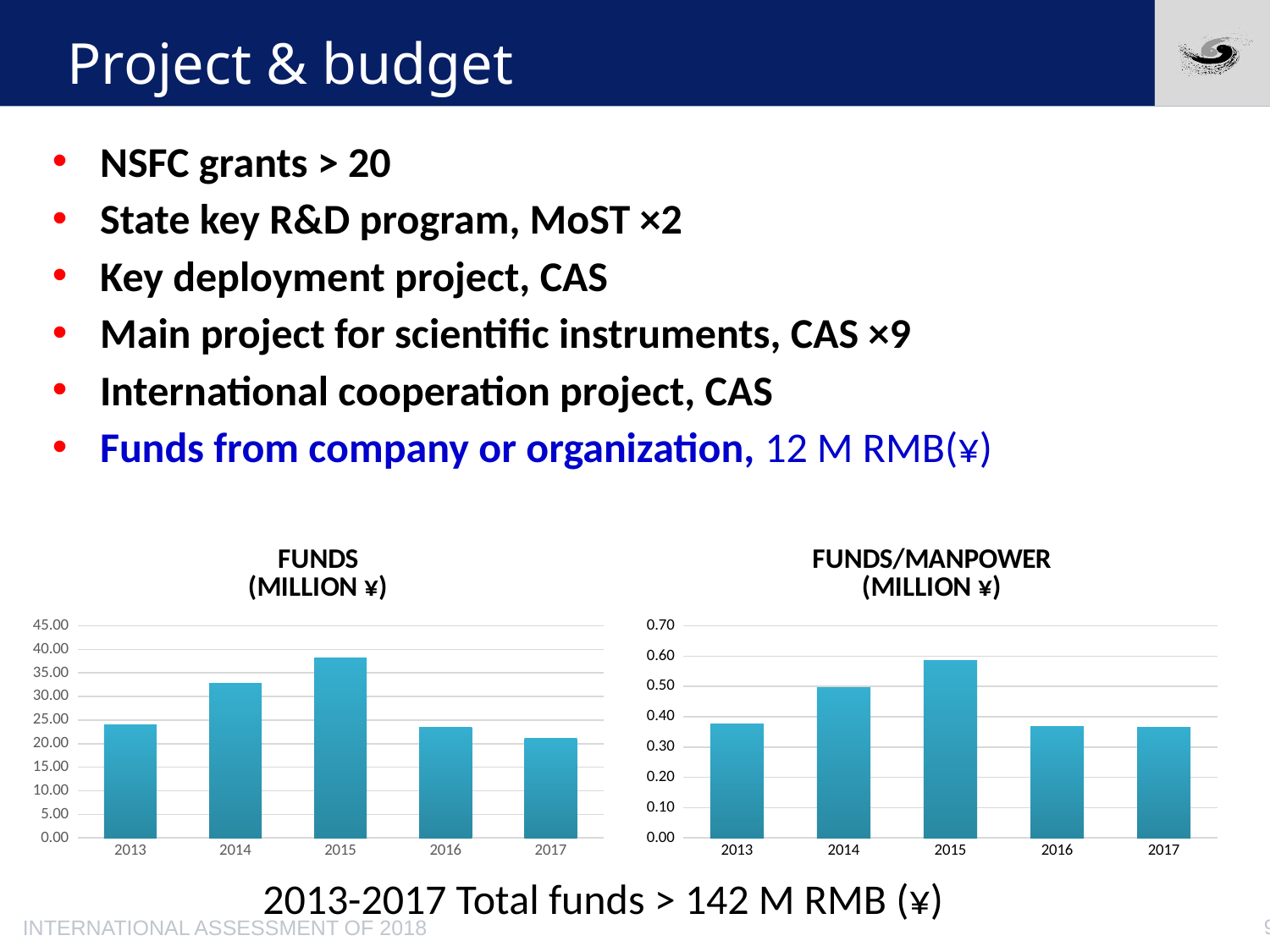
In the FUNDS/MANPOWER (MILLION ¥) chart, is the value for 2013 greater or less than 0.40? less In the FUNDS (MILLION ¥) chart, is the value for 2014 greater or less than 30.00? greater What kind of chart is the FUNDS (MILLION ¥) chart? bar chart In the FUNDS (MILLION ¥) chart, which year has the highest value? 2015 How many years are shown on the x axis of the FUNDS/MANPOWER (MILLION ¥) chart? 5 In the FUNDS (MILLION ¥) chart, which is larger, the value for 2014 or the value for 2016? 2014 In the FUNDS (MILLION ¥) chart, is the value for 2015 greater or less than 35.00? greater In the FUNDS (MILLION ¥) chart, which year has the lowest value? 2017 In the FUNDS/MANPOWER (MILLION ¥) chart, which year has the highest value? 2015 In the FUNDS/MANPOWER (MILLION ¥) chart, do the values rise or fall from 2013 to 2015? rise